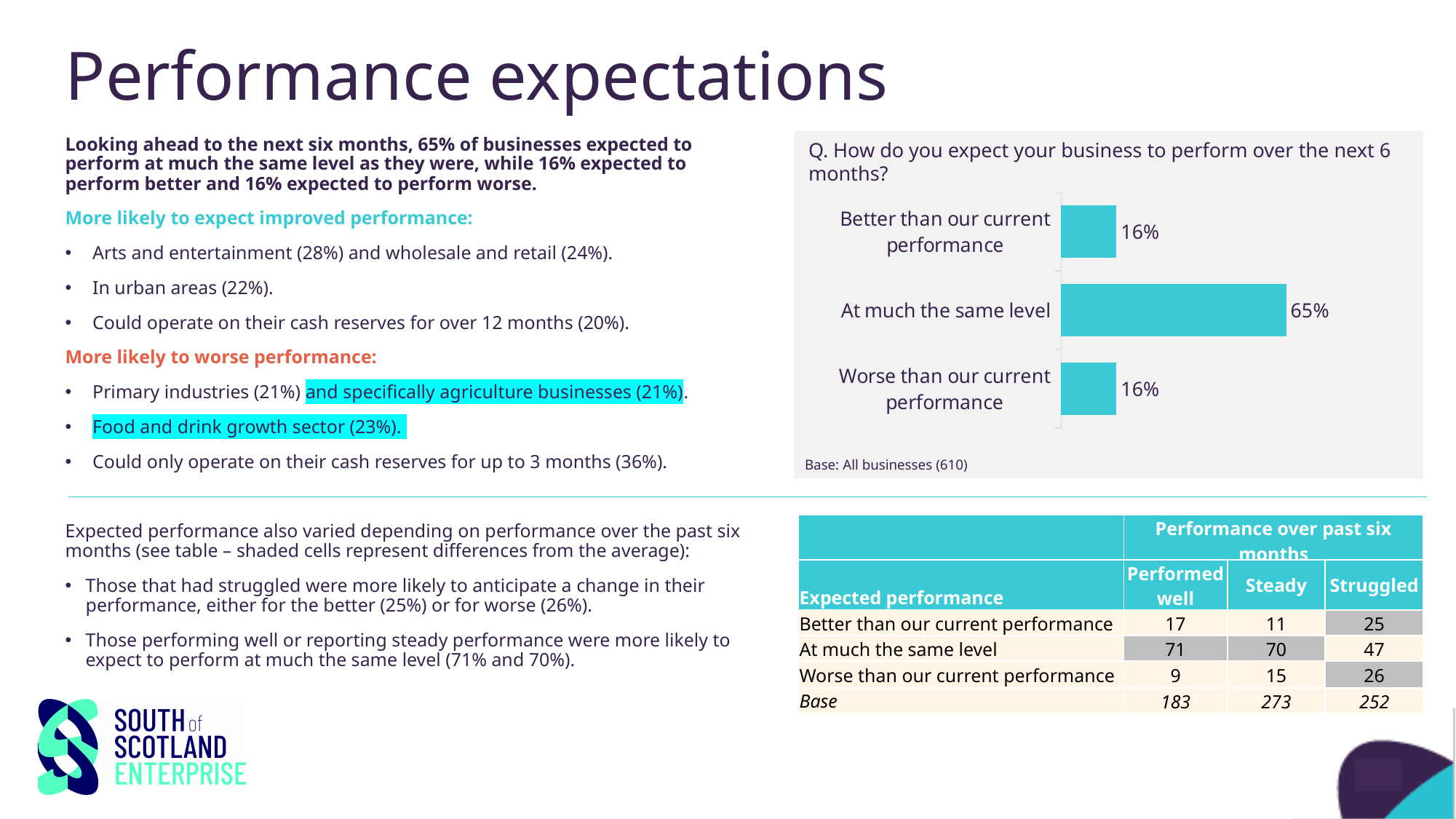
Which response category has the highest value in the chart? At much the same level Which is larger: the share expecting to perform at much the same level or the share expecting to perform worse? At much the same level How many response categories are shown in the chart? 3 What percentage of businesses expect to perform better than their current performance? 16% What percentage of businesses expect to perform worse than their current performance? 16% What question does the chart answer, as stated in its title? Q. How do you expect your business to perform over the next 6 months? What is the combined percentage of businesses expecting to perform better or worse than their current performance? 32% What is the base (number of businesses) for the chart? All businesses (610) What is the difference between the share expecting to perform at much the same level and the share expecting to perform better? 49% What type of chart is used to show the performance expectations? Bar chart What percentage of businesses expect to perform at much the same level over the next 6 months? 65%